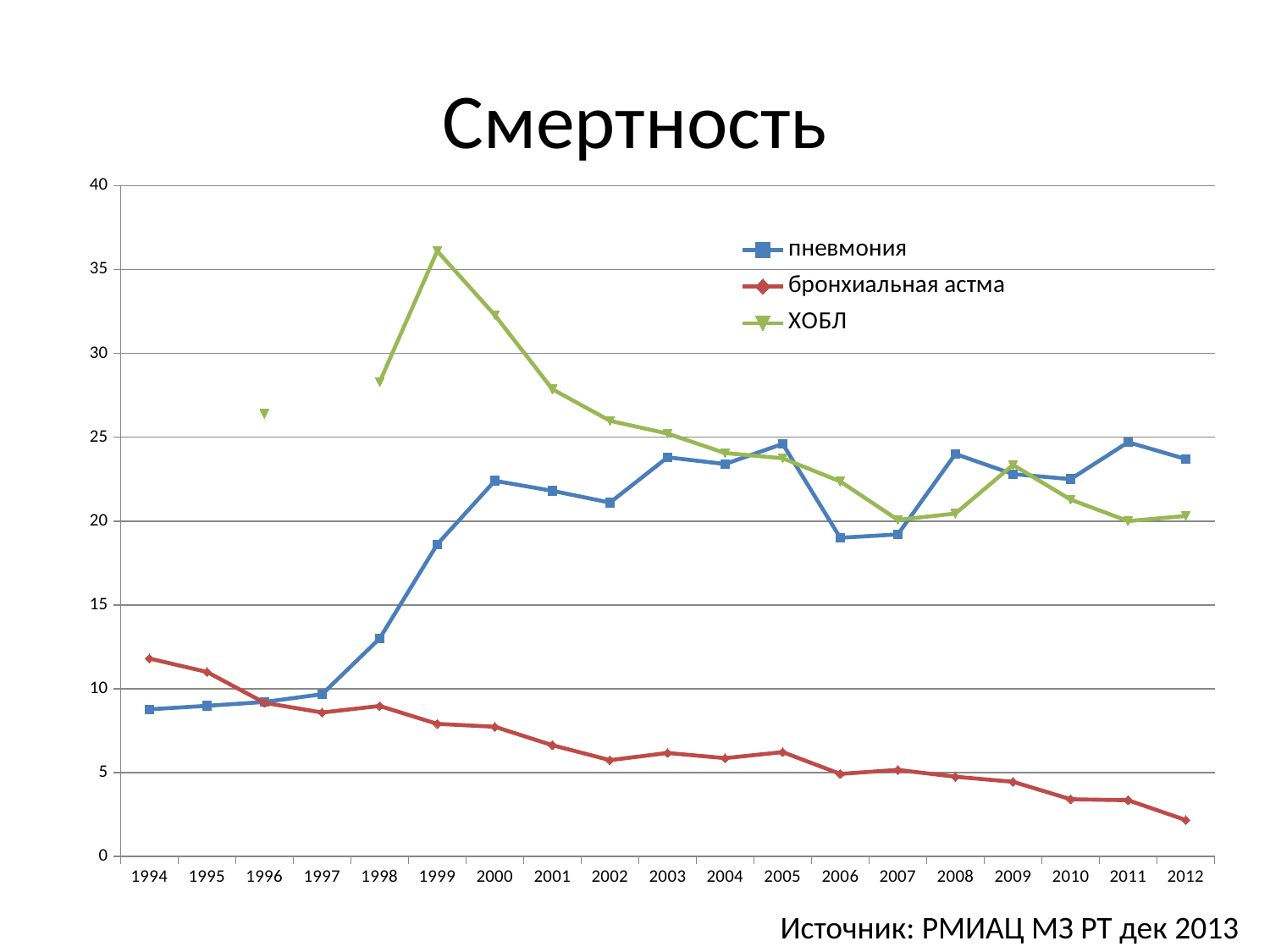
In which year does the ХОБЛ series reach its highest value? 1999 In 2006, which series has the higher value: пневмония or ХОБЛ? ХОБЛ In which year does the бронхиальная астма series reach its lowest value? 2012 Is the value for пневмония in 1994 greater or less than 10? less How many years are shown on the x axis? 19 Is the value for пневмония in 2005 greater or less than 20? greater How many series does the legend list? 3 Is the value for бронхиальная астма in 2012 greater or less than 5? less What kind of chart is shown on the slide? line chart What is the title of the chart? Смертность Does the бронхиальная астма series generally rise or fall from 1994 to 2012? fall